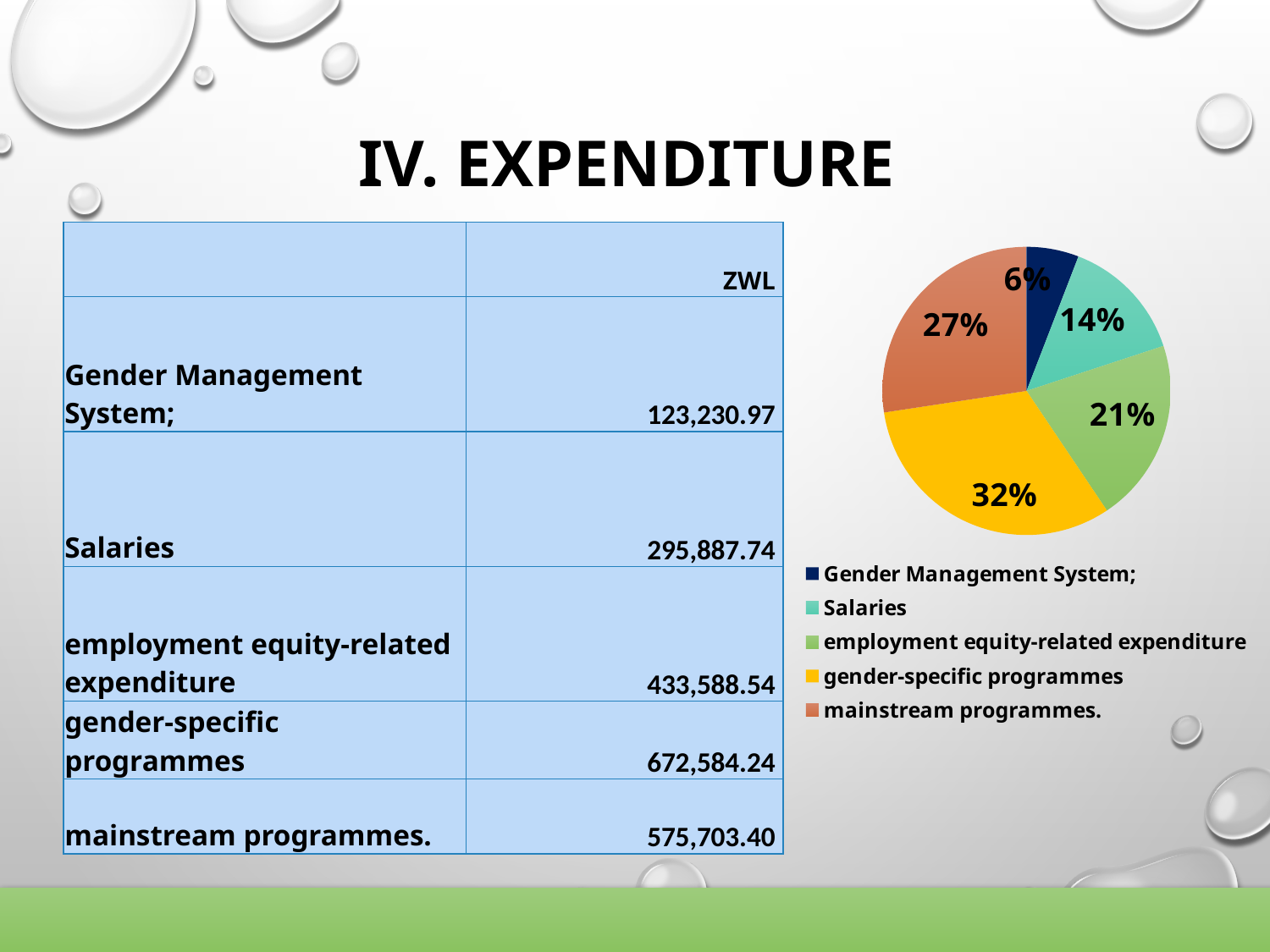
Which category has the largest slice of the pie? gender-specific programmes What type of chart is shown on the slide? pie chart Which category has the smallest slice of the pie? Gender Management System What is the difference in percentage points between the gender-specific programmes slice and the Gender Management System slice? 26 What share of the pie does mainstream programmes represent? 27% What share of the pie does employment equity-related expenditure represent? 21% What colour is the slice for gender-specific programmes? yellow How many slices does the pie chart have? 5 What share of the pie does Salaries represent? 14% Which slice is larger: mainstream programmes or Salaries? mainstream programmes